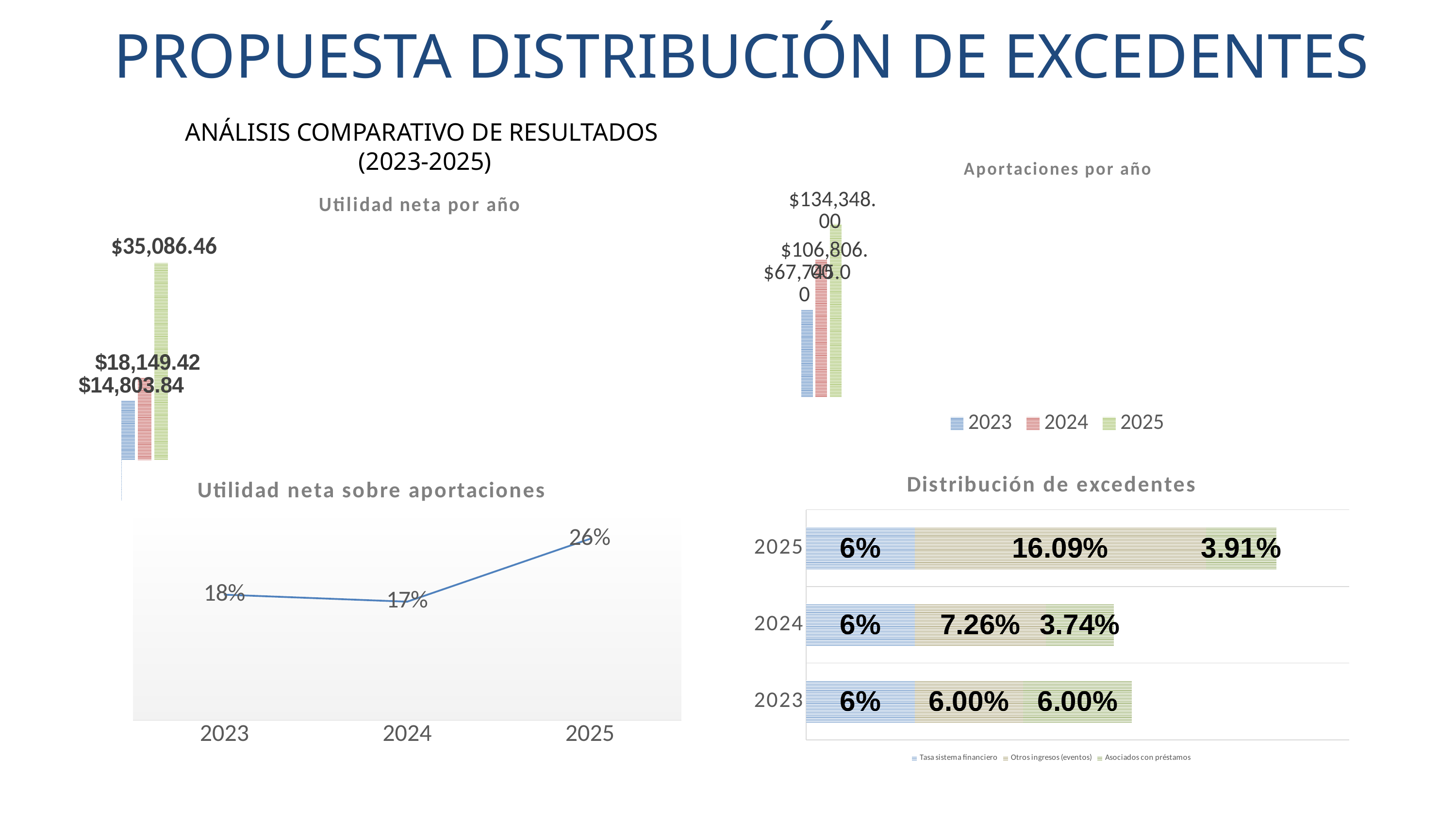
In the 'Distribución de excedentes' chart, what is the total of the stacked bar for 2024? 17% In the 'Utilidad neta por año' chart, which year has the lowest value? 2023 In the 'Aportaciones por año' chart, how many series does the legend list? 3 In the 'Aportaciones por año' chart, what is the value for 2025? $134,348.00 What kind of chart is 'Utilidad neta sobre aportaciones'? line chart In the 'Utilidad neta por año' chart, what is the value for 2025? $35,086.46 In the 'Utilidad neta sobre aportaciones' chart, which is larger, the value for 2023 or the value for 2025? 2025 In the 'Utilidad neta por año' chart, what is the difference between the 2025 and 2024 values? $16,937.04 In the 'Utilidad neta sobre aportaciones' chart, what is the value for 2024? 17% In the 'Aportaciones por año' chart, which year has the highest value? 2025 In the 'Distribución de excedentes' chart, what is the 'Otros ingresos (eventos)' value for 2025? 16.09% In the 'Distribución de excedentes' chart, what are the three legend entries? Tasa sistema financiero, Otros ingresos (eventos), Asociados con préstamos